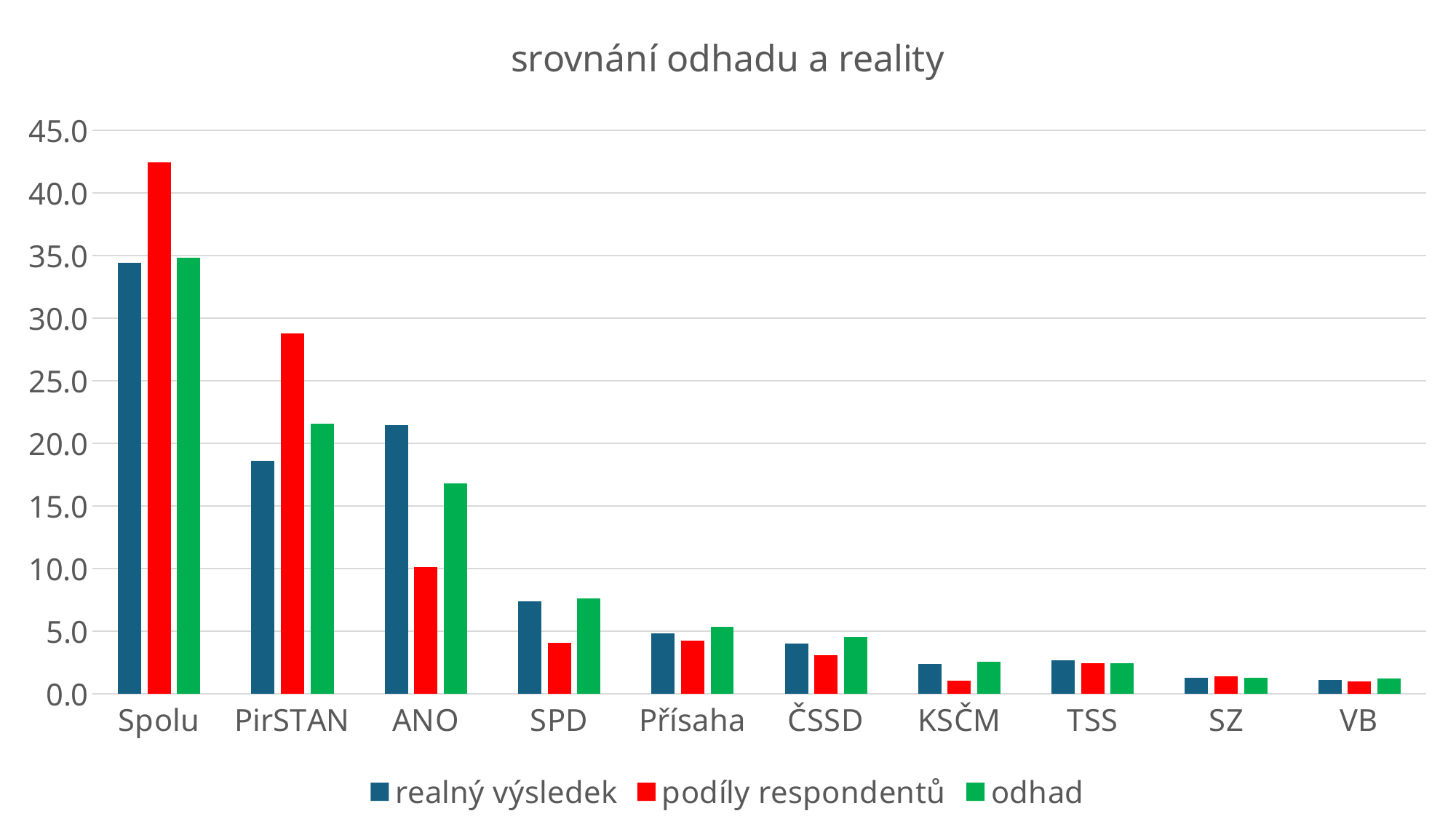
How many series does the legend list? 3 Is the value for podíly respondentů for ANO greater or less than 15.0? less What kind of chart is shown on the slide? bar chart Is the value for realný výsledek for PirSTAN greater or less than 20.0? less Is the value for odhad for SPD greater or less than 5.0? greater Which category has the highest value for realný výsledek? Spolu For PirSTAN, which is larger: podíly respondentů or realný výsledek? podíly respondentů Do the realný výsledek values generally rise or fall from left to right along the x axis? fall Which category has the highest value for podíly respondentů? Spolu How many categories are shown on the x axis? 10 For ANO, which is larger: realný výsledek or odhad? realný výsledek